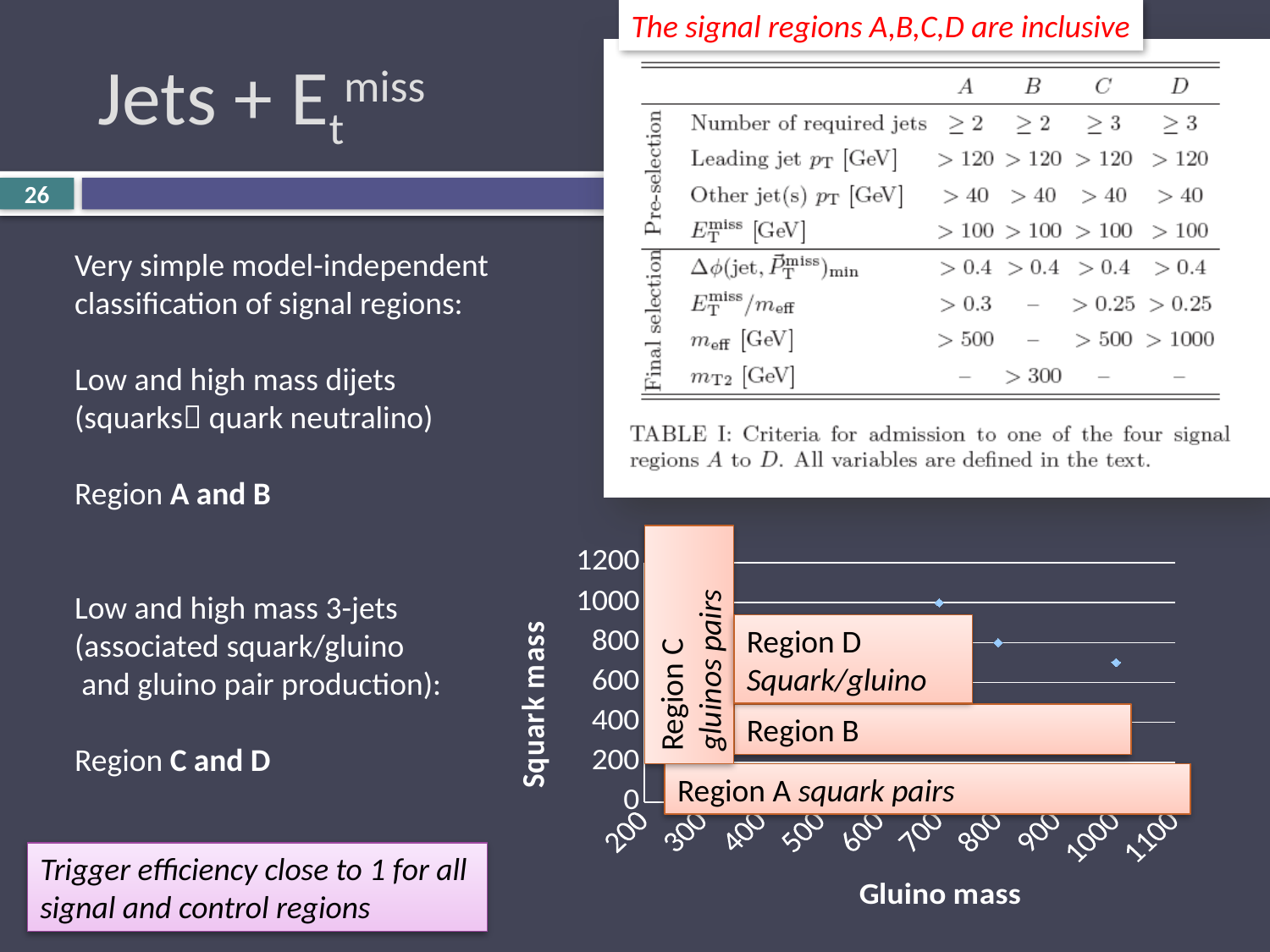
Is the squark mass of the point plotted at a gluino mass of about 700 greater or less than 800? greater Is the squark mass of the point plotted at a gluino mass of about 800 greater or less than 600? greater What kind of chart is shown at the bottom right of the slide? scatter chart Which plotted point has the highest squark mass: the one at a gluino mass of about 700 or the one at about 1000? the one at about 700 What is the highest value shown on the vertical axis of the chart? 1200 What is the title of the vertical axis of the chart? Squark mass As gluino mass increases along the x axis, do the plotted squark mass values rise or fall? fall How many tick labels are shown on the horizontal axis of the chart? 10 Is the squark mass of the point plotted at a gluino mass of about 1000 greater or less than 600? greater What is the title of the horizontal axis of the chart? Gluino mass